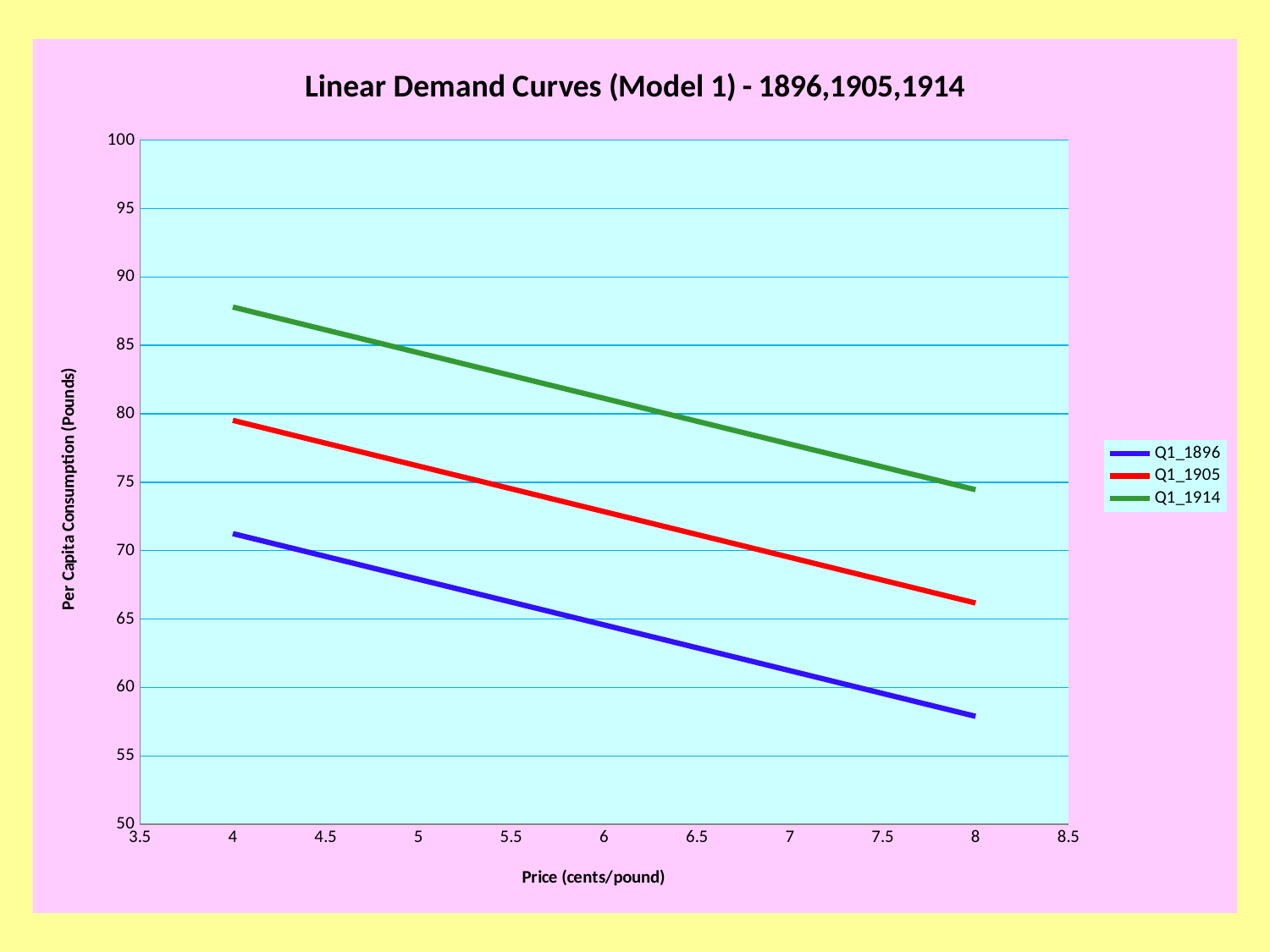
Which series has the lowest per capita consumption across the price range? Q1_1896 Is the value for Q1_1914 at a price of 4 greater or less than 85? greater Which series has the highest per capita consumption across the price range? Q1_1914 How many series does the legend list? 3 What kind of chart is shown on the slide? line chart Is the value for Q1_1896 at a price of 4 greater or less than 70? greater What is the label of the x axis? Price (cents/pound) Is the value for Q1_1896 at a price of 8 greater or less than 60? less At a price of 6, which series has the larger value, Q1_1905 or Q1_1896? Q1_1905 What is the title of the chart? Linear Demand Curves (Model 1) - 1896,1905,1914 Do the values of the Q1_1905 series rise or fall as price increases along the x axis? fall